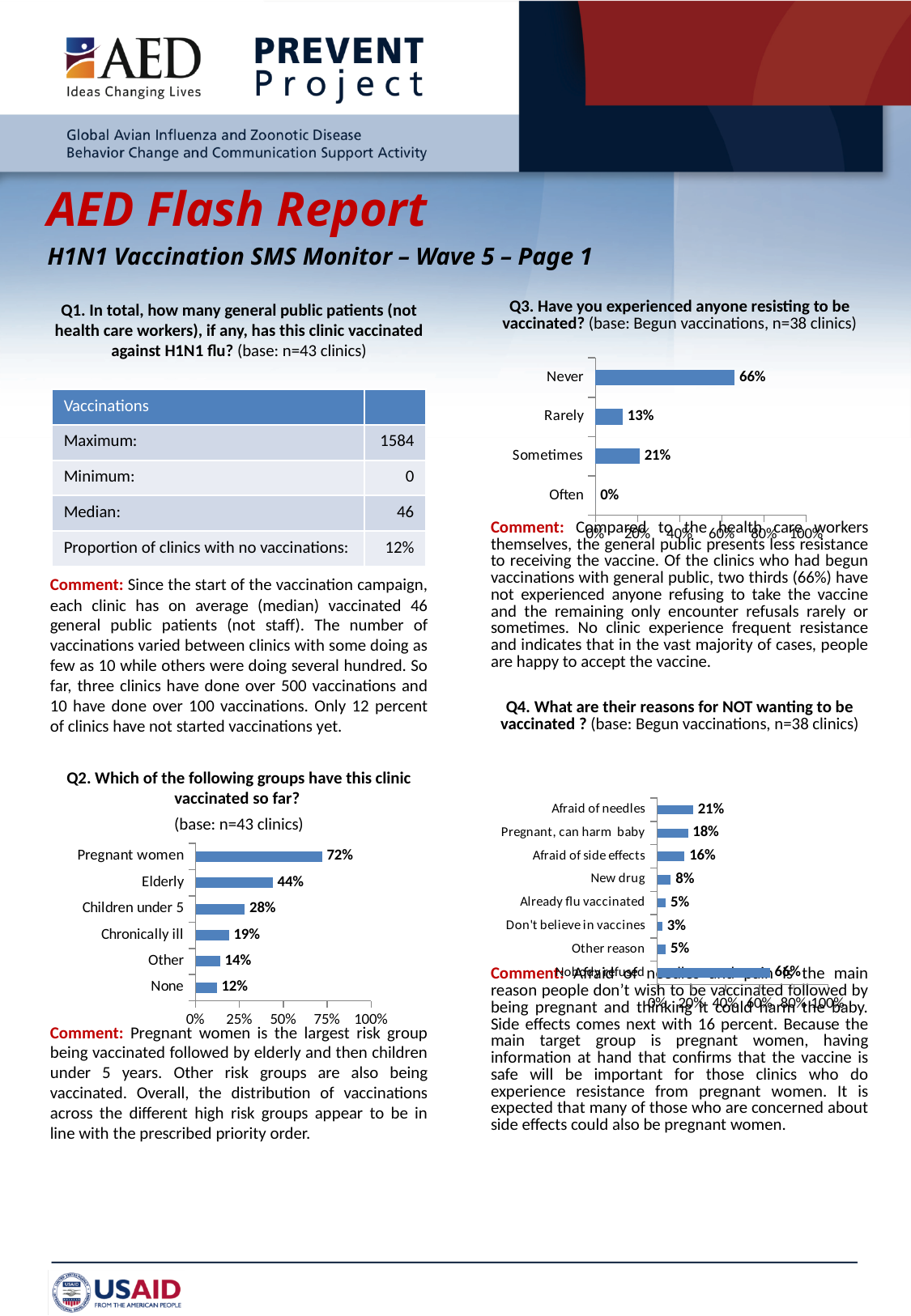
In the Q3 chart (experienced anyone resisting to be vaccinated), which category has the lowest value? Often In the Q3 chart (experienced anyone resisting to be vaccinated), what is the value for Never? 66% In the Q4 chart (reasons for NOT wanting to be vaccinated), what is the value for Afraid of needles? 21% In the Q3 chart (experienced anyone resisting to be vaccinated), which is larger, Rarely or Sometimes? Sometimes In the Q2 chart (groups vaccinated so far), which group has the highest value? Pregnant women In the Q4 chart (reasons for NOT wanting to be vaccinated), what is the value for Don't believe in vaccines? 3% In the Q2 chart (groups vaccinated so far), is the value for Chronically ill greater or less than 25%? less In the Q2 chart (groups vaccinated so far), how many categories are plotted? 6 What kind of chart is the Q3 chart (experienced anyone resisting to be vaccinated)? Bar chart In the Q2 chart (groups vaccinated so far), what is the difference between the values for Elderly and Children under 5? 16% In the Q4 chart (reasons for NOT wanting to be vaccinated), what is the difference between Pregnant, can harm baby and Afraid of side effects? 2% In the Q2 chart (groups vaccinated so far), what percentage of clinics have vaccinated pregnant women? 72%